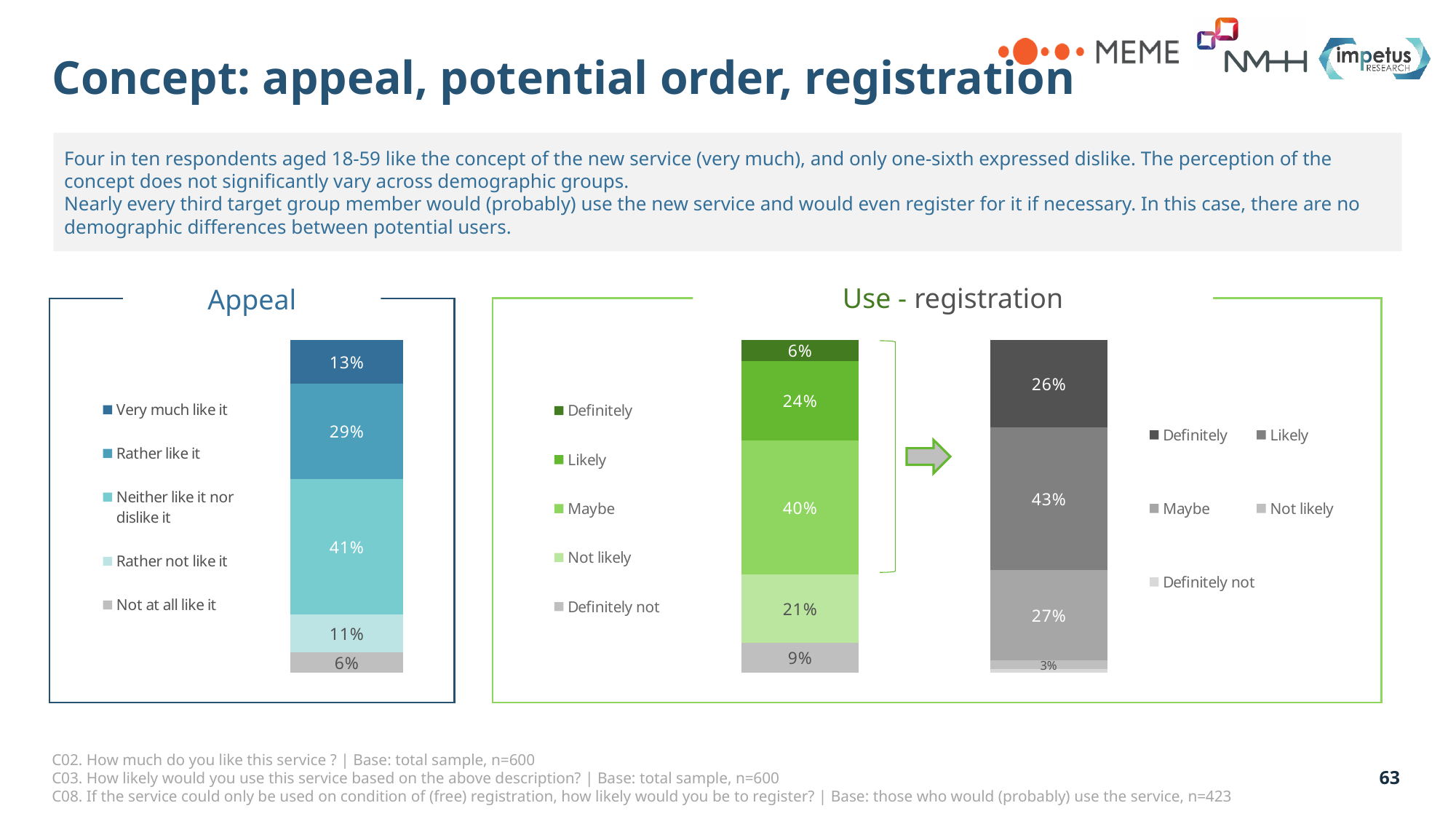
In the registration chart (grey bar), what is the difference between "Likely" and "Definitely"? 17% In the Appeal chart, which response category has the smallest share? Not at all like it In the Appeal chart, what percentage of respondents answered "Neither like it nor dislike it"? 41% In the Use chart (green bar), what is the total of all segments in the stacked bar? 100% In the Appeal chart, what percentage of respondents answered "Very much like it"? 13% In the Appeal chart, which response category has the largest share? Neither like it nor dislike it In the Use chart (green bar), what percentage of respondents answered "Definitely"? 6% In the registration chart (grey bar), what percentage of respondents answered "Likely"? 43% In the Appeal chart, what is the difference between "Rather like it" and "Rather not like it"? 18% In the Use chart (green bar), what percentage of respondents answered "Maybe"? 40% How many entries does the legend of the registration chart (grey bar) list? 5 In the Use chart (green bar), which is larger: "Likely" or "Not likely"? Likely